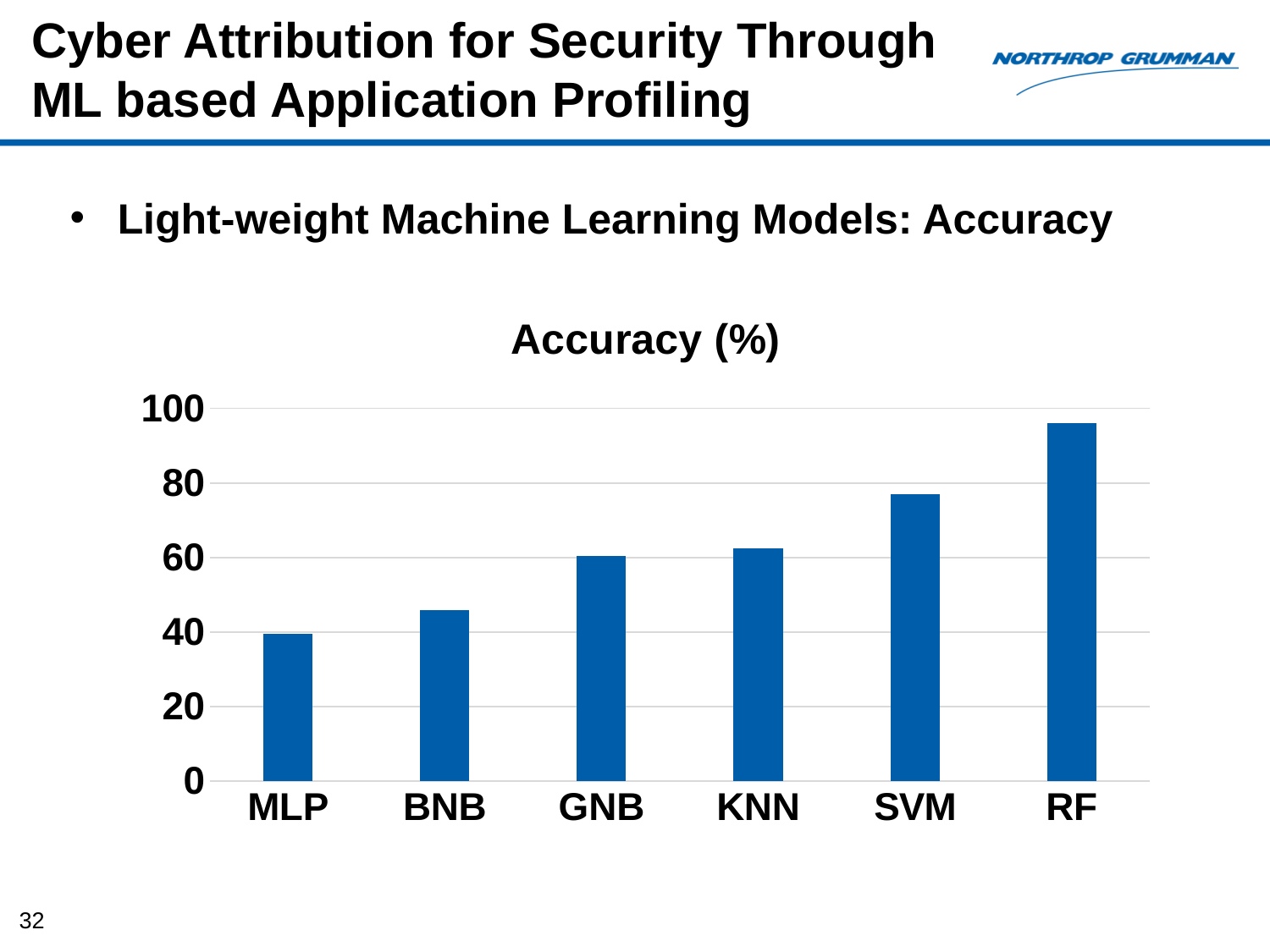
Is the accuracy for MLP greater or less than 20? greater What is the title of the chart? Accuracy (%) Which has a higher accuracy, BNB or KNN? KNN Which has a higher accuracy, SVM or GNB? SVM Is the accuracy for SVM greater or less than 80? less What kind of chart is shown on the slide? bar chart Which model has the lowest accuracy in the chart? MLP Which model has the highest accuracy in the chart? RF How many models (categories) are shown on the x axis of the chart? 6 Do the accuracy values rise or fall moving from MLP to RF along the x axis? rise Is the accuracy for BNB greater or less than 60? less